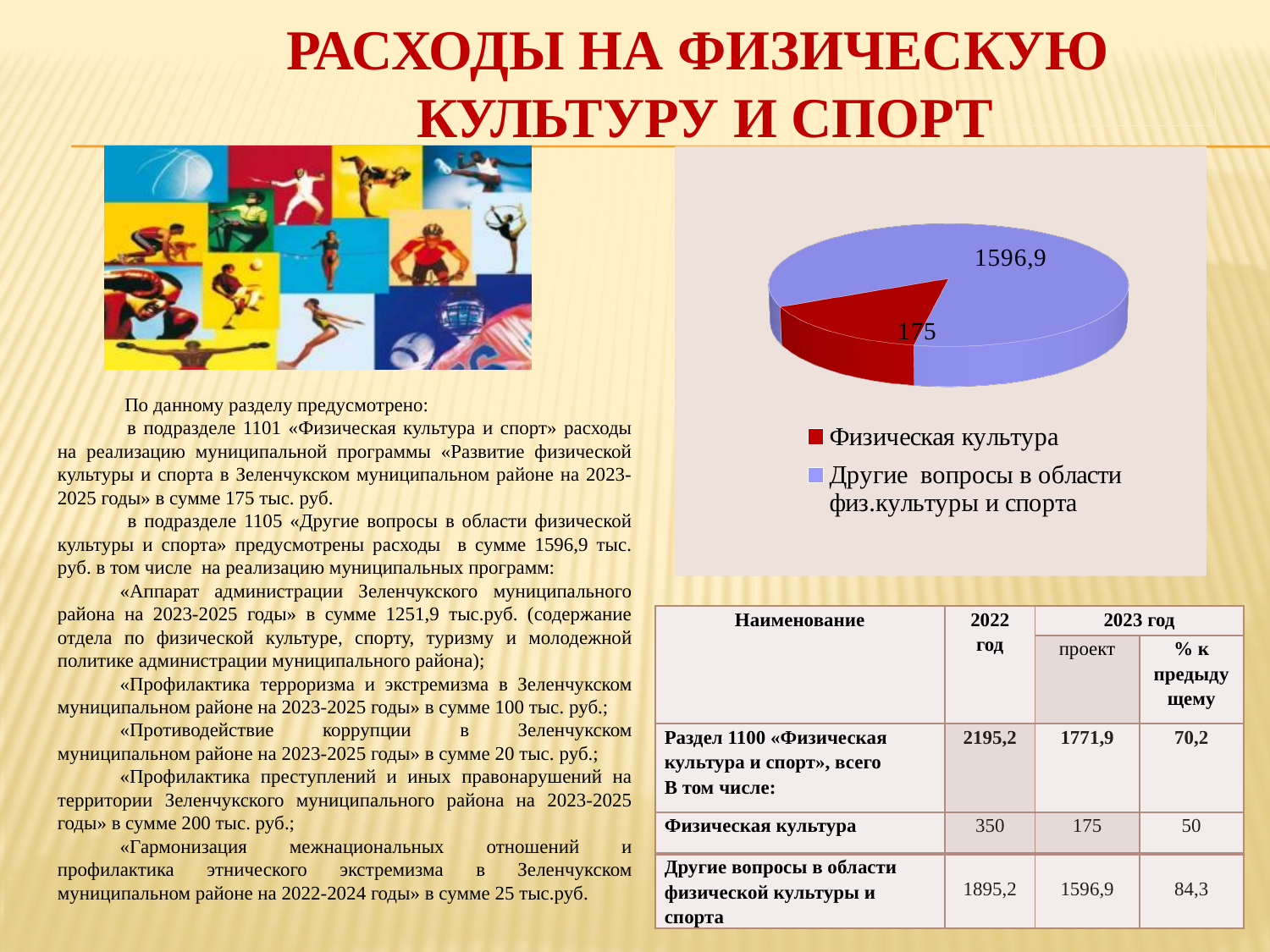
How many slices does the pie chart have? 2 What colour is the Физическая культура slice in the pie chart? red Which slice of the pie chart is the largest? Другие вопросы в области физ.культуры и спорта What is the difference between the two slices of the pie chart (1596,9 and 175)? 1421,9 How many entries does the legend of the pie chart list? 2 Which is larger in the pie chart: Физическая культура or Другие вопросы в области физ.культуры и спорта? Другие вопросы в области физ.культуры и спорта What kind of chart is shown on the slide? pie chart What is the value for Другие вопросы в области физ.культуры и спорта in the pie chart? 1596,9 What colour is the Другие вопросы в области физ.культуры и спорта slice in the pie chart? blue Which slice of the pie chart is the smallest? Физическая культура What is the total of the two values shown in the pie chart? 1771,9 What is the value for Физическая культура in the pie chart? 175